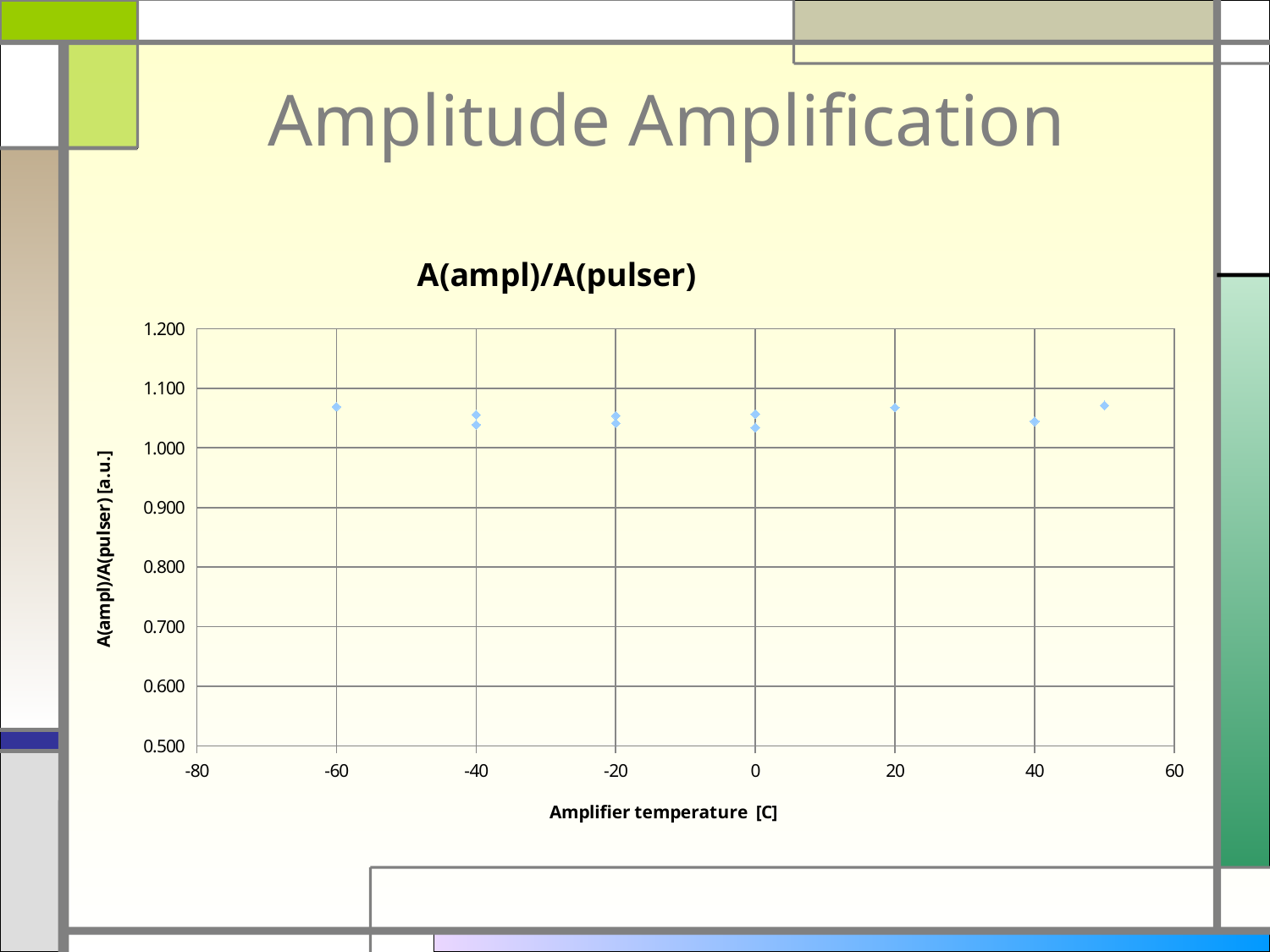
What is the label of the x axis? Amplifier temperature [C] Do the plotted values rise strongly, fall strongly, or stay roughly flat as the amplifier temperature increases from -60 to 50? stay roughly flat What is the title of the chart? A(ampl)/A(pulser) What is the lowest value shown on the y axis? 0.500 Is the value at an amplifier temperature of -60 greater or less than 1.000? greater At how many distinct amplifier temperatures are points plotted? 7 What kind of chart is shown on the slide? scatter chart Are all the plotted values greater or less than 0.900? greater Is the value at an amplifier temperature of 40 greater or less than 1.100? less